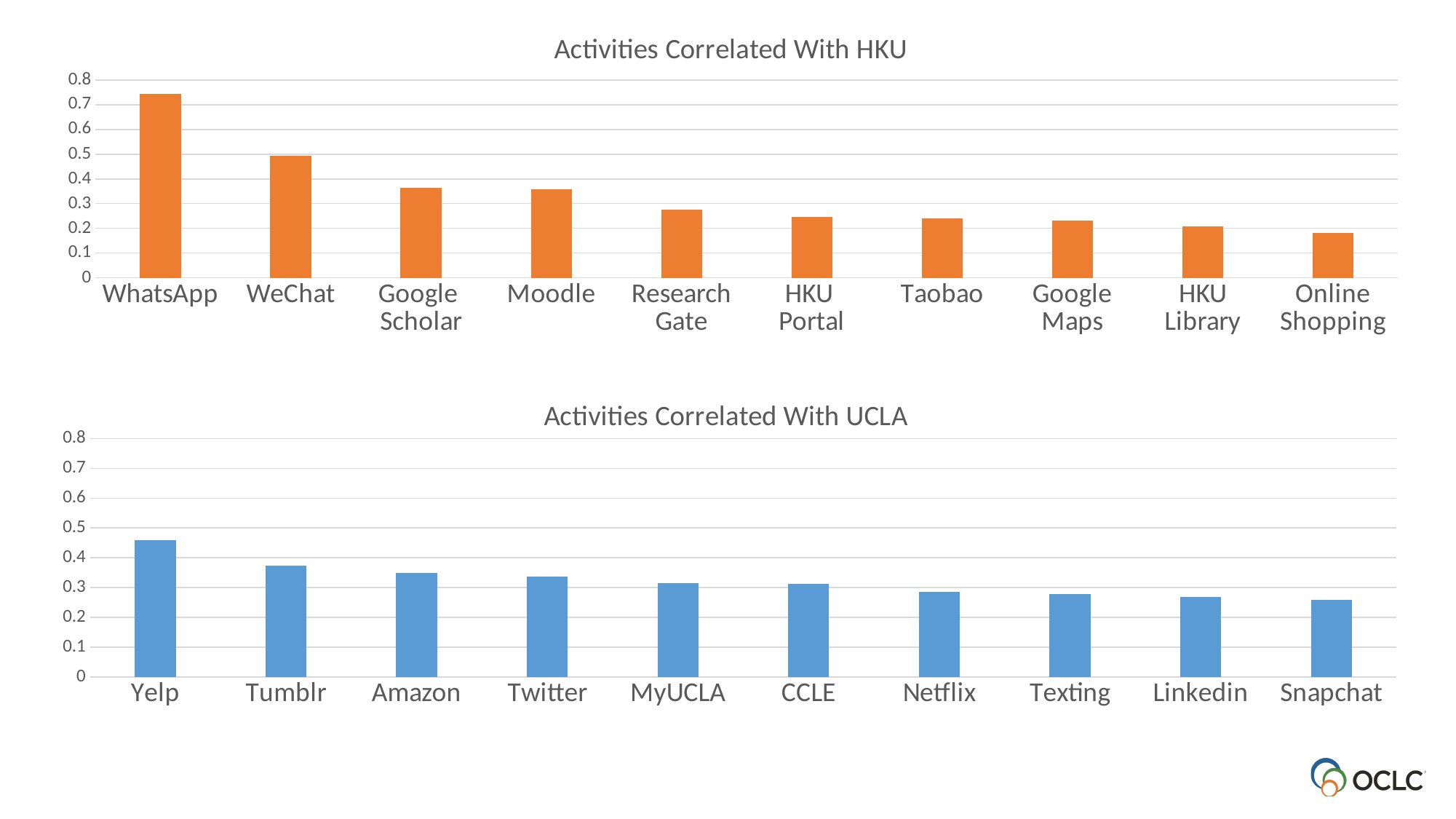
In the 'Activities Correlated With HKU' chart, which is larger, WhatsApp or WeChat? WhatsApp How many activities are shown in the 'Activities Correlated With HKU' chart? 10 How many activities are shown in the 'Activities Correlated With UCLA' chart? 10 In the 'Activities Correlated With HKU' chart, which activity has the lowest value? Online Shopping In the 'Activities Correlated With HKU' chart, do the values rise or fall from left to right? fall In the 'Activities Correlated With UCLA' chart, is the value for Yelp greater or less than 0.4? greater In the 'Activities Correlated With HKU' chart, is the value for WeChat greater or less than 0.4? greater In the 'Activities Correlated With UCLA' chart, which activity has the lowest value? Snapchat In the 'Activities Correlated With HKU' chart, which activity has the highest value? WhatsApp What kind of chart is the 'Activities Correlated With UCLA' chart? Bar chart What colour are the bars in the 'Activities Correlated With UCLA' chart? Blue In the 'Activities Correlated With UCLA' chart, which activity has the highest value? Yelp